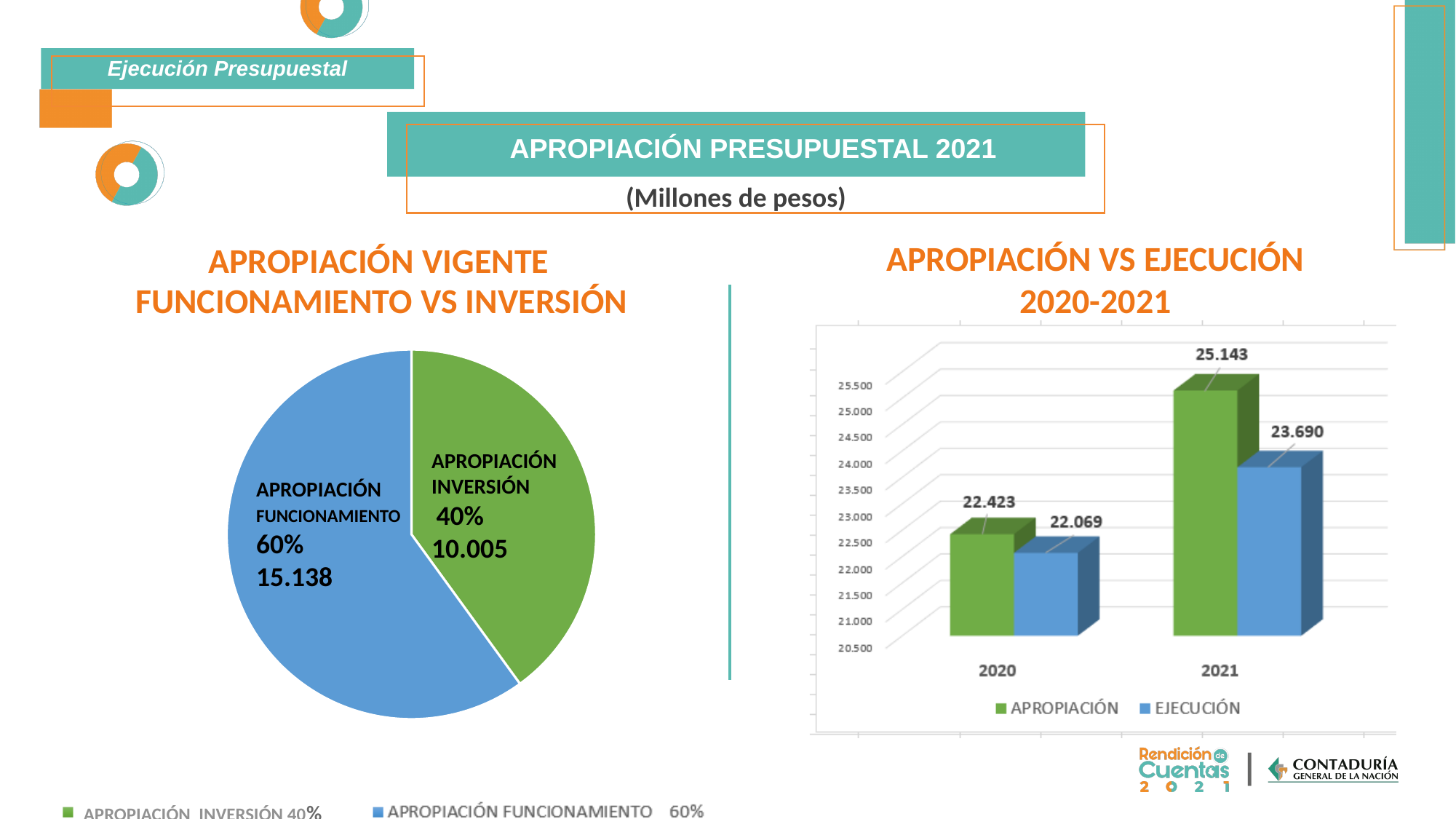
In the chart 'APROPIACIÓN VS EJECUCIÓN 2020-2021', does the APROPIACIÓN value rise or fall from 2020 to 2021? Rise What type of chart is 'APROPIACIÓN VS EJECUCIÓN 2020-2021'? Bar chart In the pie chart 'APROPIACIÓN VIGENTE FUNCIONAMIENTO VS INVERSIÓN', what value is shown for APROPIACIÓN FUNCIONAMIENTO? 15.138 In the pie chart 'APROPIACIÓN VIGENTE FUNCIONAMIENTO VS INVERSIÓN', what value is shown for APROPIACIÓN INVERSIÓN? 10.005 In the pie chart 'APROPIACIÓN VIGENTE FUNCIONAMIENTO VS INVERSIÓN', which slice is larger, FUNCIONAMIENTO or INVERSIÓN? APROPIACIÓN FUNCIONAMIENTO In the chart 'APROPIACIÓN VS EJECUCIÓN 2020-2021', what is the APROPIACIÓN value for 2021? 25.143 In the chart 'APROPIACIÓN VS EJECUCIÓN 2020-2021', what is the EJECUCIÓN value for 2020? 22.069 In the chart 'APROPIACIÓN VS EJECUCIÓN 2020-2021', what is the difference between APROPIACIÓN and EJECUCIÓN in 2021? 1.453 In the pie chart 'APROPIACIÓN VIGENTE FUNCIONAMIENTO VS INVERSIÓN', what share does APROPIACIÓN FUNCIONAMIENTO have? 60% In the chart 'APROPIACIÓN VS EJECUCIÓN 2020-2021', how many series does the legend list? 2 In the pie chart 'APROPIACIÓN VIGENTE FUNCIONAMIENTO VS INVERSIÓN', how many slices are there? 2 What type of chart is 'APROPIACIÓN VIGENTE FUNCIONAMIENTO VS INVERSIÓN'? Pie chart